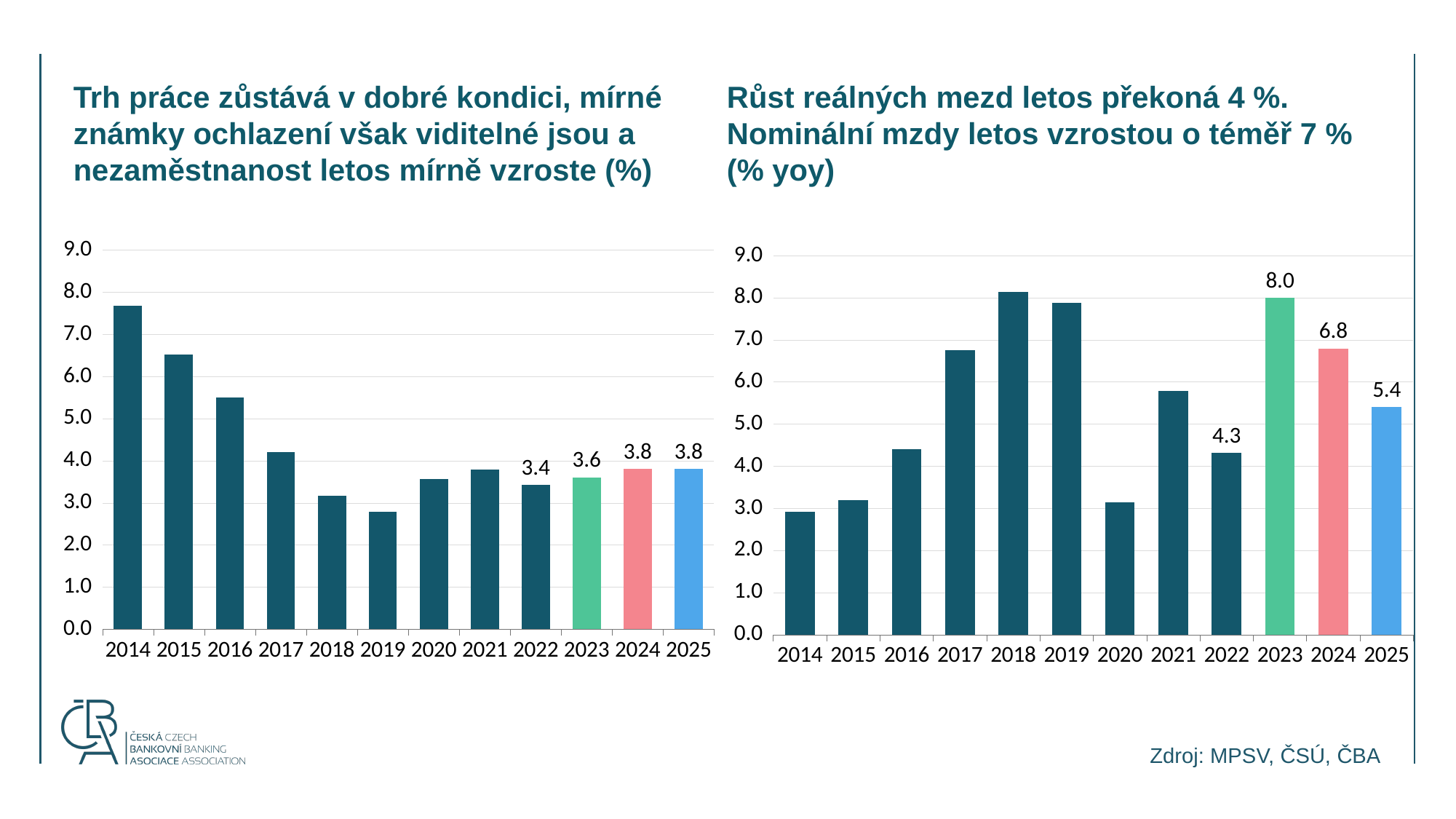
In the left chart (unemployment), how many years are shown on the x axis? 12 In the right chart (nominal wage growth), which year has the larger value, 2024 or 2025? 2024 In the left chart (unemployment), what is the difference between the values for 2023 and 2022? 0.2 In the right chart (nominal wage growth), what is the value for 2025? 5.4 In the left chart (unemployment), is the value for 2014 greater or less than 7.0? greater In the left chart (unemployment), which year has the highest value? 2014 In the right chart (nominal wage growth), what is the difference between the values for 2023 and 2024? 1.2 In the right chart (nominal wage growth), what is the value for 2023? 8.0 In the left chart (unemployment), which year has the lowest value? 2019 In the left chart (unemployment), what is the value for 2024? 3.8 What type of chart is the right chart (nominal wage growth)? bar chart In the left chart (unemployment), what is the value for 2022? 3.4